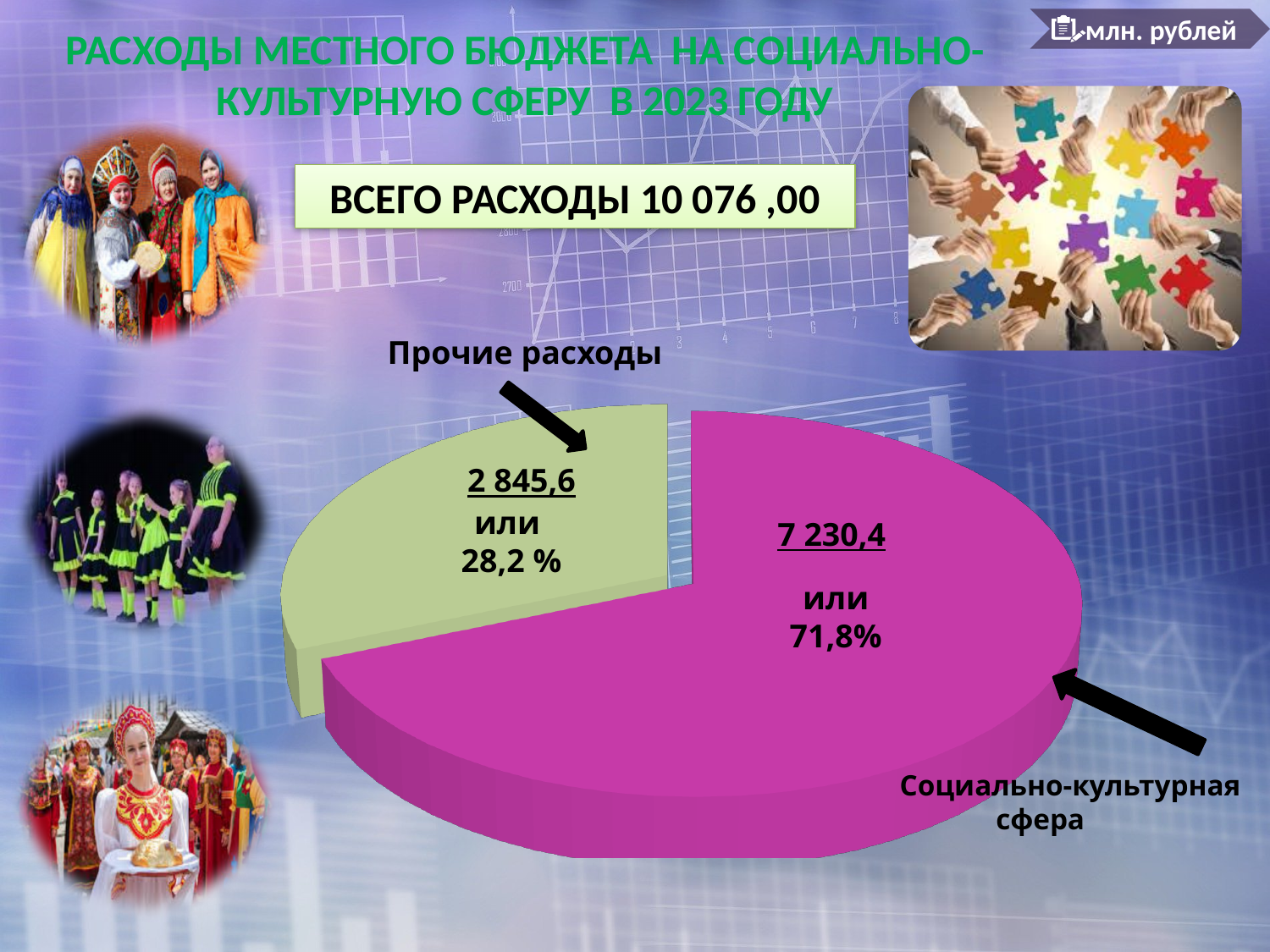
Which slice is the largest? Социально-культурная сфера What is the value for Социально-культурная сфера? 7 230,4 Which is larger, Социально-культурная сфера or Прочие расходы? Социально-культурная сфера What share of the pie does Прочие расходы take? 28,2 % What is the difference between the values for Социально-культурная сфера and Прочие расходы? 4 384,8 What colour is the Социально-культурная сфера slice? magenta (pink) What share of the pie does Социально-культурная сфера take? 71,8% What kind of chart is shown on the slide? pie chart How many slices does the pie chart have? 2 What total expenditure is stated on the slide (ВСЕГО РАСХОДЫ)? 10 076 ,00 What is the value for Прочие расходы? 2 845,6 Which slice is the smallest? Прочие расходы